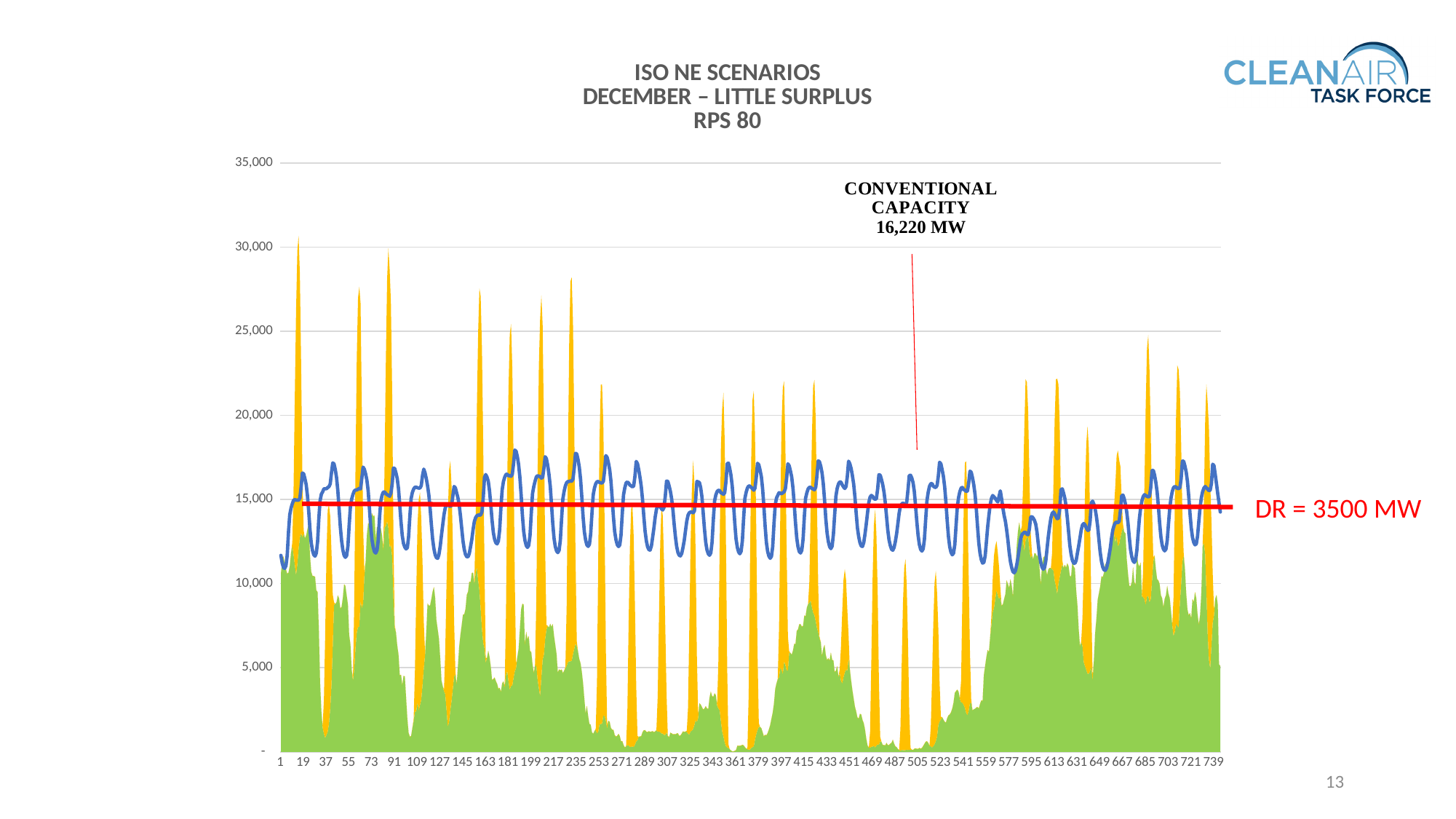
What DR value is labelled next to the red horizontal line? 3500 MW Is the green area's peak near x = 91 greater or less than 10,000? greater What is the title of the chart? ISO NE SCENARIOS DECEMBER – LITTLE SURPLUS RPS 80 Is the tallest yellow peak on the chart greater or less than 25,000? greater Is the yellow peak near x = 19 greater or less than 20,000? greater What is the difference between the annotated conventional capacity and the DR value? 12,720 MW What is the highest value shown on the vertical axis? 35,000 What conventional capacity value is annotated on the chart? 16,220 MW What kind of chart is shown on the slide? area and line chart Which annotated value is larger, the conventional capacity or the DR? Conventional capacity